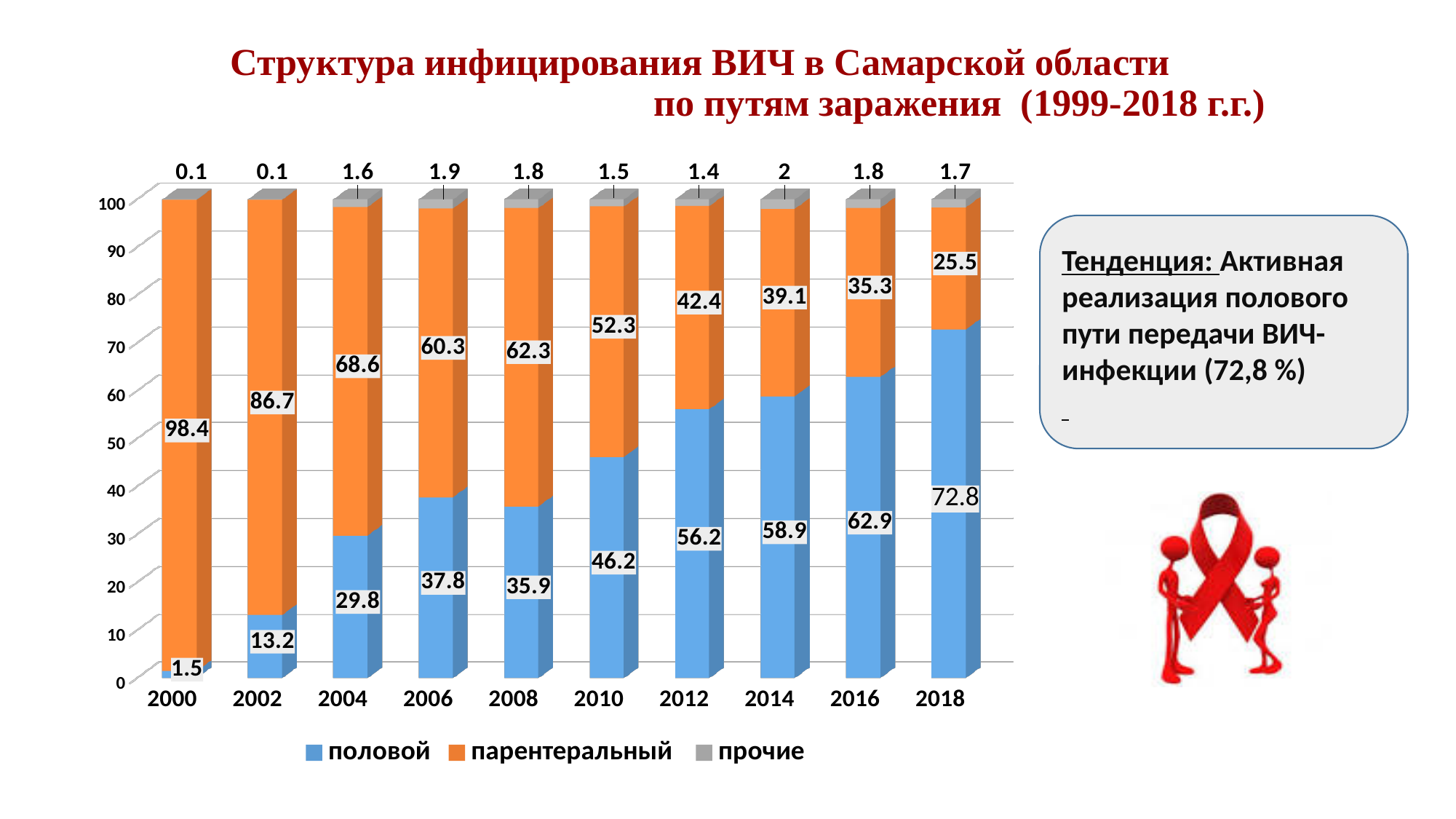
In which year is the половой series highest? 2018 In which year is the парентеральный series highest? 2000 How many series does the legend list? 3 Does the половой series rise or fall from 2000 to 2018? rise What is the value of the парентеральный series for 2000? 98.4 What is the value of the половой series for 2010? 46.2 How many years are shown on the x axis? 10 What is the value of the прочие series for 2014? 2 For 2012, which is larger: половой or парентеральный? половой In which year is the половой series lowest? 2000 What is the value of the половой series for 2018? 72.8 What is the difference between the половой values for 2018 and 2016? 9.9